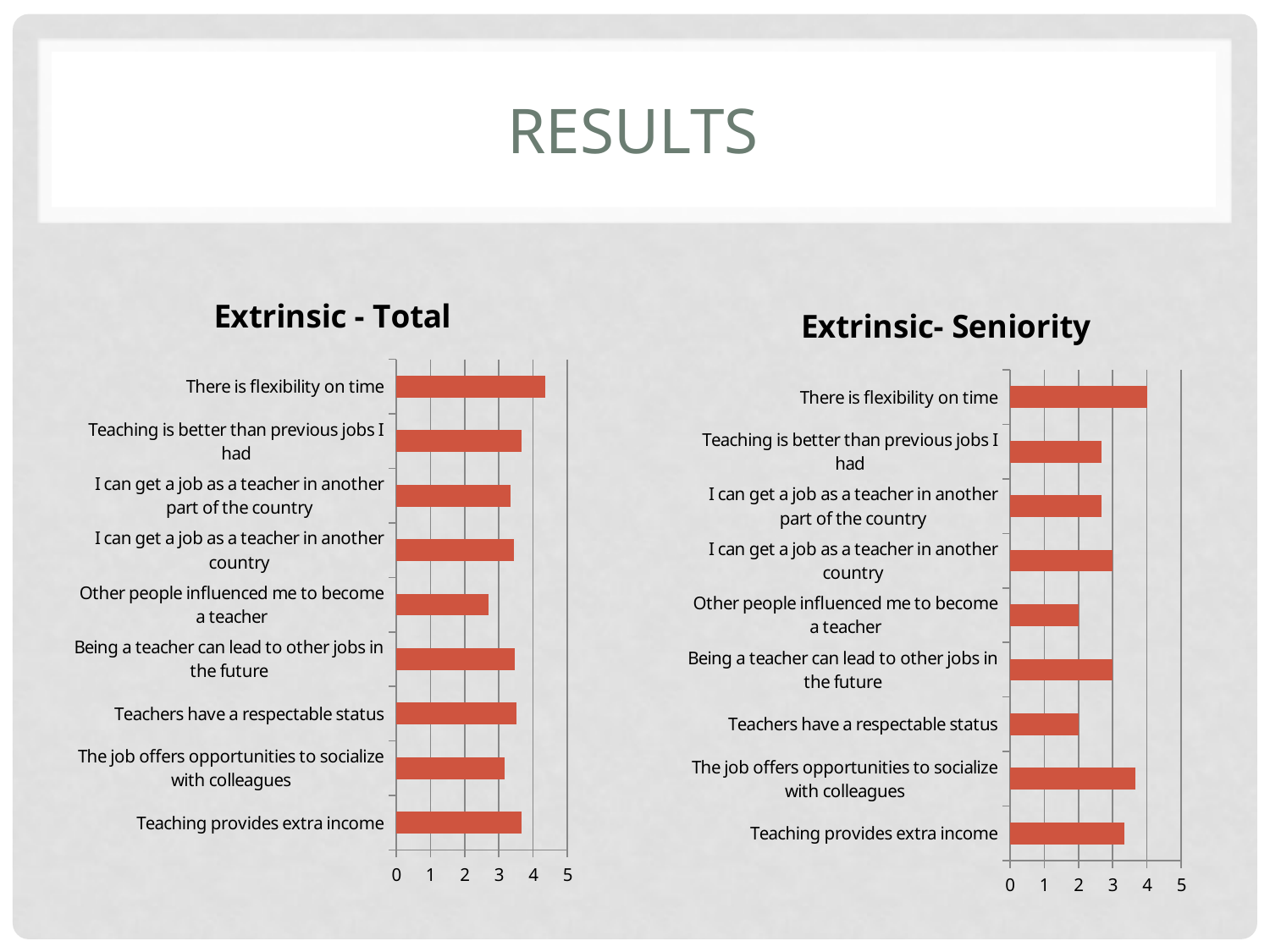
In the "Extrinsic - Total" chart, is the value for "Other people influenced me to become a teacher" greater or less than 3? less How many categories are shown in the "Extrinsic- Seniority" chart? 9 In the "Extrinsic - Total" chart, which is larger: the value for "There is flexibility on time" or the value for "The job offers opportunities to socialize with colleagues"? There is flexibility on time What kind of chart is the "Extrinsic - Total" chart? bar chart In the "Extrinsic - Total" chart, is the value for "There is flexibility on time" greater or less than 4? greater In the "Extrinsic- Seniority" chart, which category has the highest value? There is flexibility on time In the "Extrinsic- Seniority" chart, which is larger: the value for "The job offers opportunities to socialize with colleagues" or the value for "Teachers have a respectable status"? The job offers opportunities to socialize with colleagues What is the title of the chart on the right side of the slide? Extrinsic- Seniority In the "Extrinsic - Total" chart, which category has the highest value? There is flexibility on time In the "Extrinsic - Total" chart, which category has the lowest value? Other people influenced me to become a teacher In the "Extrinsic- Seniority" chart, is the value for "The job offers opportunities to socialize with colleagues" greater or less than 3? greater